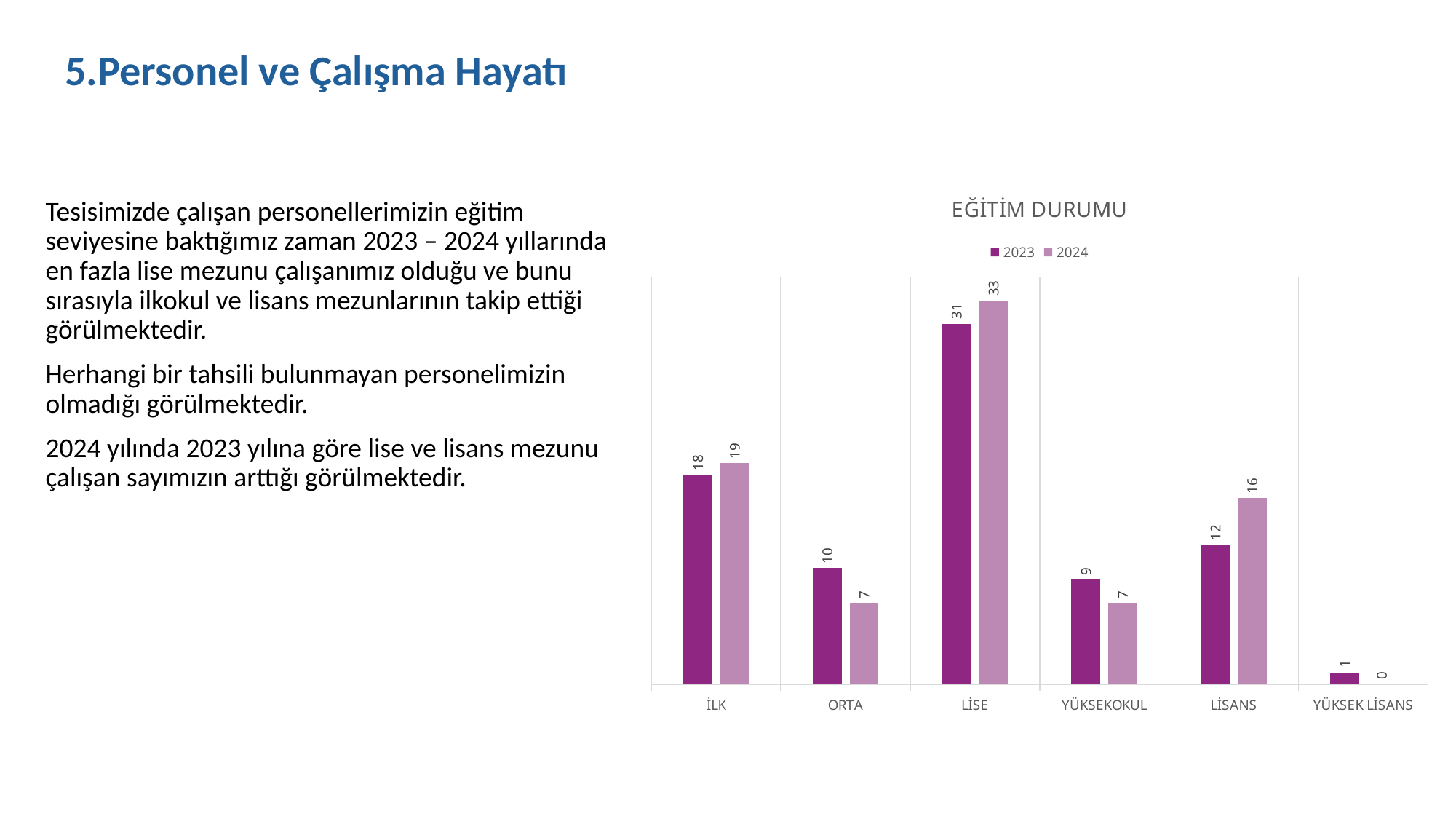
What is the value for LİSANS in the 2023 series? 12 What is the difference between the 2023 and 2024 values for ORTA? 3 What is the value for LİSE in the 2024 series? 33 Which category has the lowest value in the 2024 series? YÜKSEK LİSANS How many series does the legend list? 2 What is the difference between the 2024 and 2023 values for LİSANS? 4 What is the value for YÜKSEK LİSANS in the 2024 series? 0 Which category has the highest value in the 2023 series? LİSE What is the title of the chart? EĞİTİM DURUMU Which is larger for YÜKSEKOKUL, the 2023 value or the 2024 value? 2023 How many categories are shown on the x axis? 6 What kind of chart is shown on the slide? Bar chart